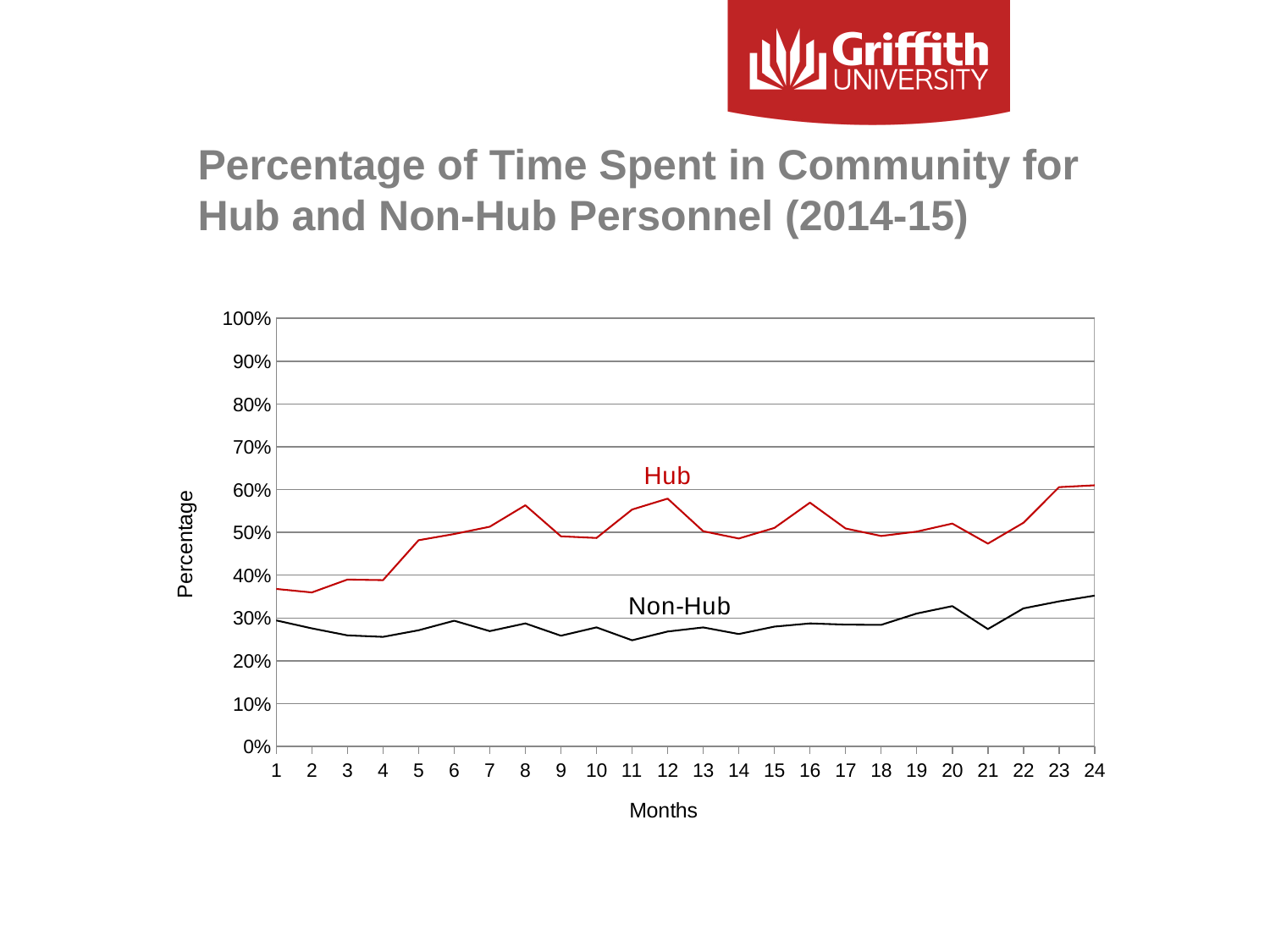
Which series has the higher values throughout the chart, Hub or Non-Hub? Hub Is the Hub value at month 1 greater or less than 40%? less How many months are shown along the x axis of the chart? 24 Is the Non-Hub value at month 24 greater or less than 30%? greater Is the Hub value at month 8 greater or less than 50%? greater How many series are plotted on the chart? 2 What colour is the Hub line on the chart? Red What is the title of the chart on the slide? Percentage of Time Spent in Community for Hub and Non-Hub Personnel (2014-15) What kind of chart is shown on the slide? Line chart Does the Hub line overall rise or fall from month 1 to month 24? rise